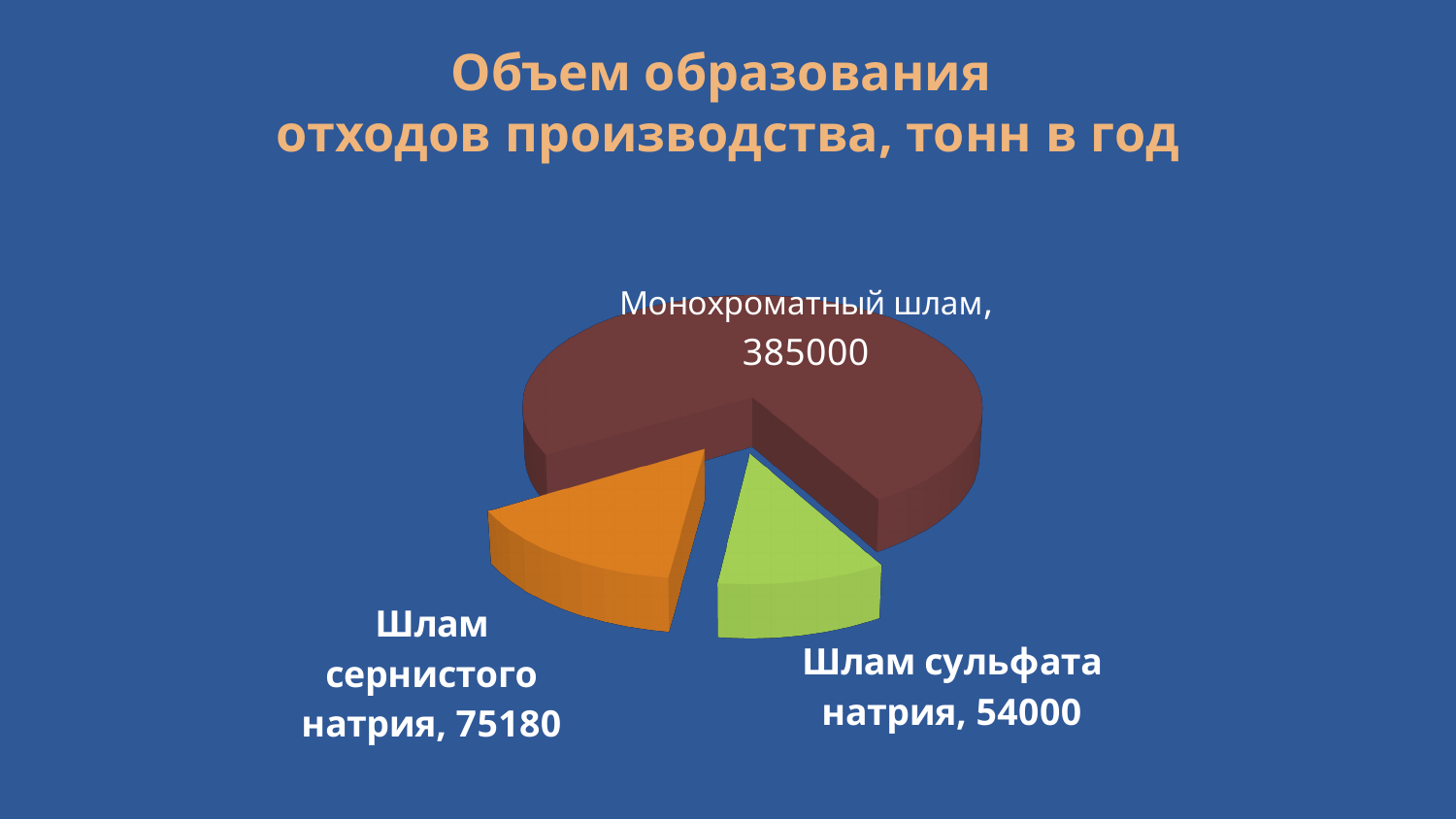
What is the difference between the values for Шлам сернистого натрия and Шлам сульфата натрия? 21180 Which category has the largest slice of the pie? Монохроматный шлам What is the total of all three slices in the pie chart? 514180 Which category has the smallest slice of the pie? Шлам сульфата натрия What kind of chart is shown on the slide? Pie chart What is the value for Монохроматный шлам? 385000 What is the title of the chart? Объем образования отходов производства, тонн в год Which is larger, the value for Шлам сернистого натрия or the value for Шлам сульфата натрия? Шлам сернистого натрия How many categories are shown in the pie chart? 3 What is the value for Шлам сернистого натрия? 75180 What is the value for Шлам сульфата натрия? 54000 What is the difference between the values for Монохроматный шлам and Шлам сернистого натрия? 309820